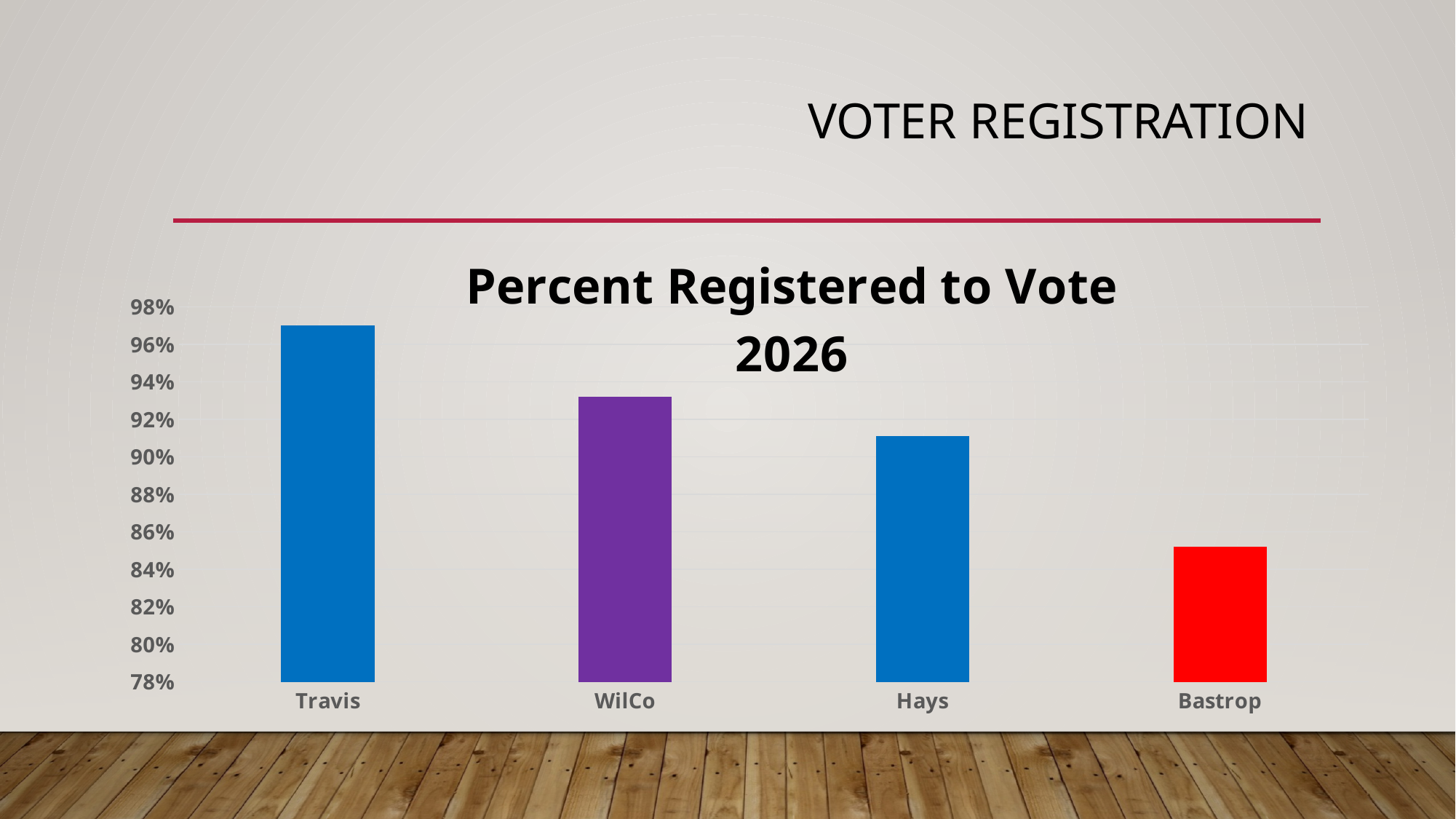
Which has a higher percent registered to vote, WilCo or Hays? WilCo Is the value for Travis greater or less than 96%? greater Is the value for WilCo greater or less than 92%? greater What is the title of the chart? Percent Registered to Vote 2026 What type of chart is shown on the slide? bar chart What colour is the bar for Bastrop? red Which county has the highest percent registered to vote? Travis Do the values rise or fall moving from Travis to Bastrop along the x axis? fall Is the value for Bastrop greater or less than 86%? less Which county has the lowest percent registered to vote? Bastrop How many counties are shown in the chart? 4